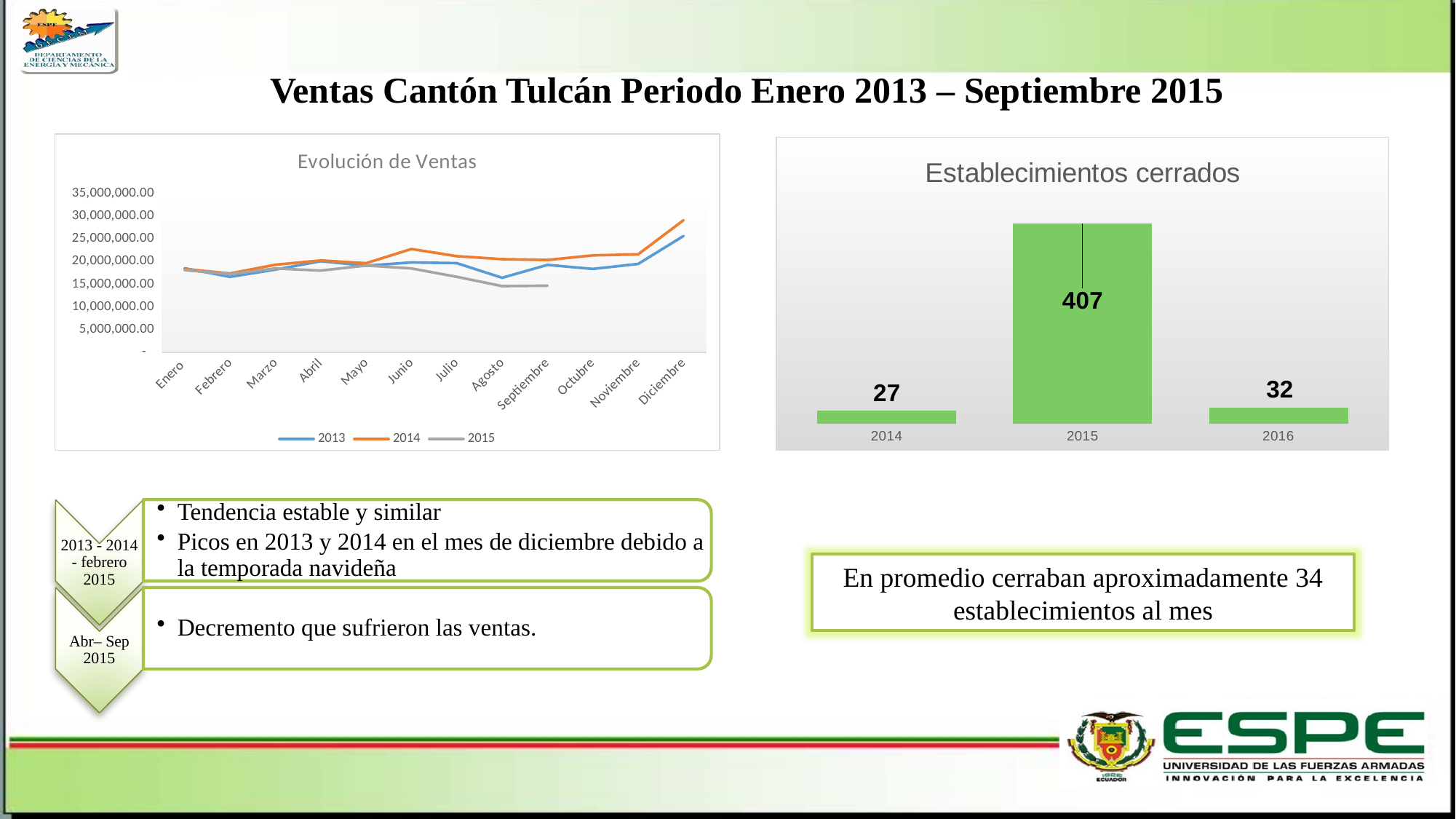
In the 'Establecimientos cerrados' chart, how many categories are shown on the x axis? 3 What kind of chart is 'Establecimientos cerrados'? Bar chart In the 'Establecimientos cerrados' chart, which year has the highest value? 2015 What kind of chart is 'Evolución de Ventas'? Line chart How many series does the legend of the 'Evolución de Ventas' chart list? 3 In the 'Evolución de Ventas' chart, is the value for 2014 in Diciembre greater or less than 25,000,000.00? greater In the 'Establecimientos cerrados' chart, what is the difference between the values for 2015 and 2016? 375 In the 'Establecimientos cerrados' chart, which year has the lowest value? 2014 In the 'Establecimientos cerrados' chart, what is the value for 2015? 407 In the 'Establecimientos cerrados' chart, what is the value for 2016? 32 In the 'Establecimientos cerrados' chart, what is the value for 2014? 27